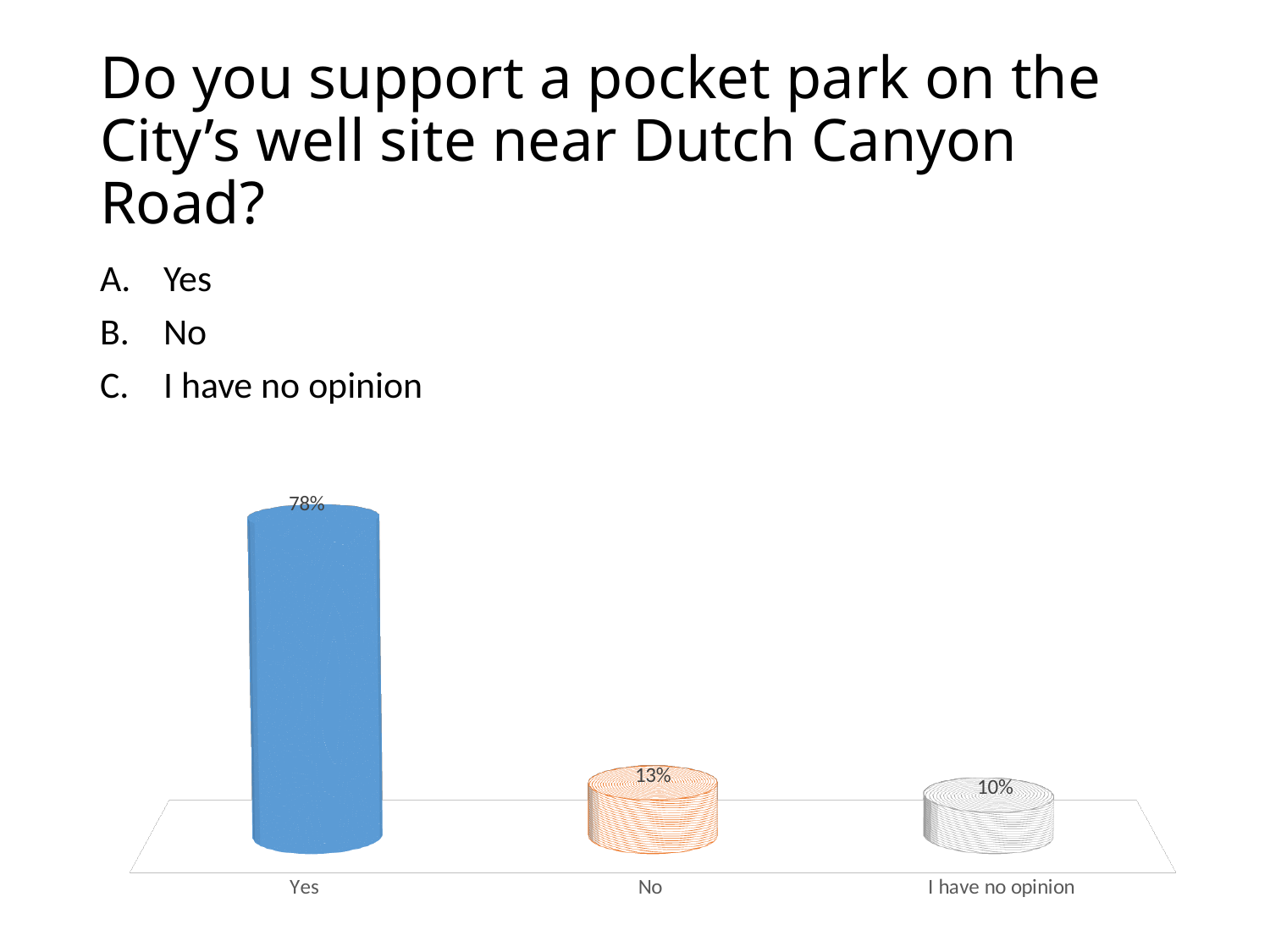
What percentage of respondents answered No? 13% Which is larger, the value for No or the value for 'I have no opinion'? No What is the difference between the No and 'I have no opinion' percentages? 3% What percentage of respondents answered Yes? 78% What percentage of respondents answered 'I have no opinion'? 10% Which response category has the highest value? Yes Which response category has the lowest value? I have no opinion What colour is the bar for Yes? Blue Do the values rise or fall from left to right across the categories? Fall What kind of chart is shown on the slide? Bar chart What is the difference between the Yes and No percentages? 65% How many response categories are shown in the chart? 3